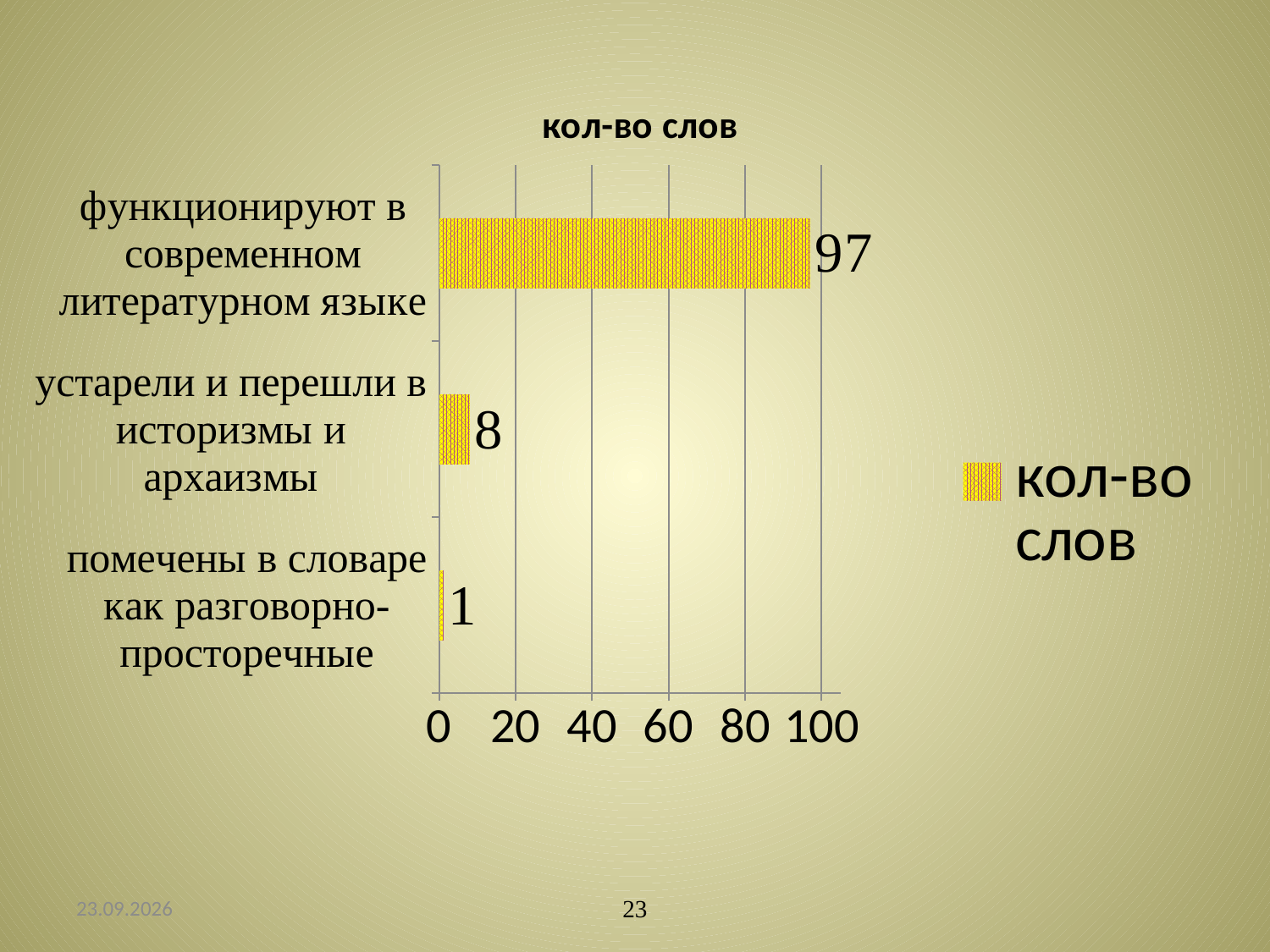
What is the value for 'помечены в словаре как разговорно-просторечные'? 1 How many series does the legend list? 1 What is the value for 'функционируют в современном литературном языке'? 97 Is the value for 'функционируют в современном литературном языке' greater or less than 80? greater What kind of chart is shown on the slide? bar chart Which category has the highest value? функционируют в современном литературном языке Which is larger: the value for 'устарели и перешли в историзмы и архаизмы' or for 'помечены в словаре как разговорно-просторечные'? устарели и перешли в историзмы и архаизмы What is the difference between the values for 'функционируют в современном литературном языке' and 'устарели и перешли в историзмы и архаизмы'? 89 What is the value for 'устарели и перешли в историзмы и архаизмы'? 8 What is the title of the chart? кол-во слов How many categories are shown in the chart? 3 Which category has the lowest value? помечены в словаре как разговорно-просторечные